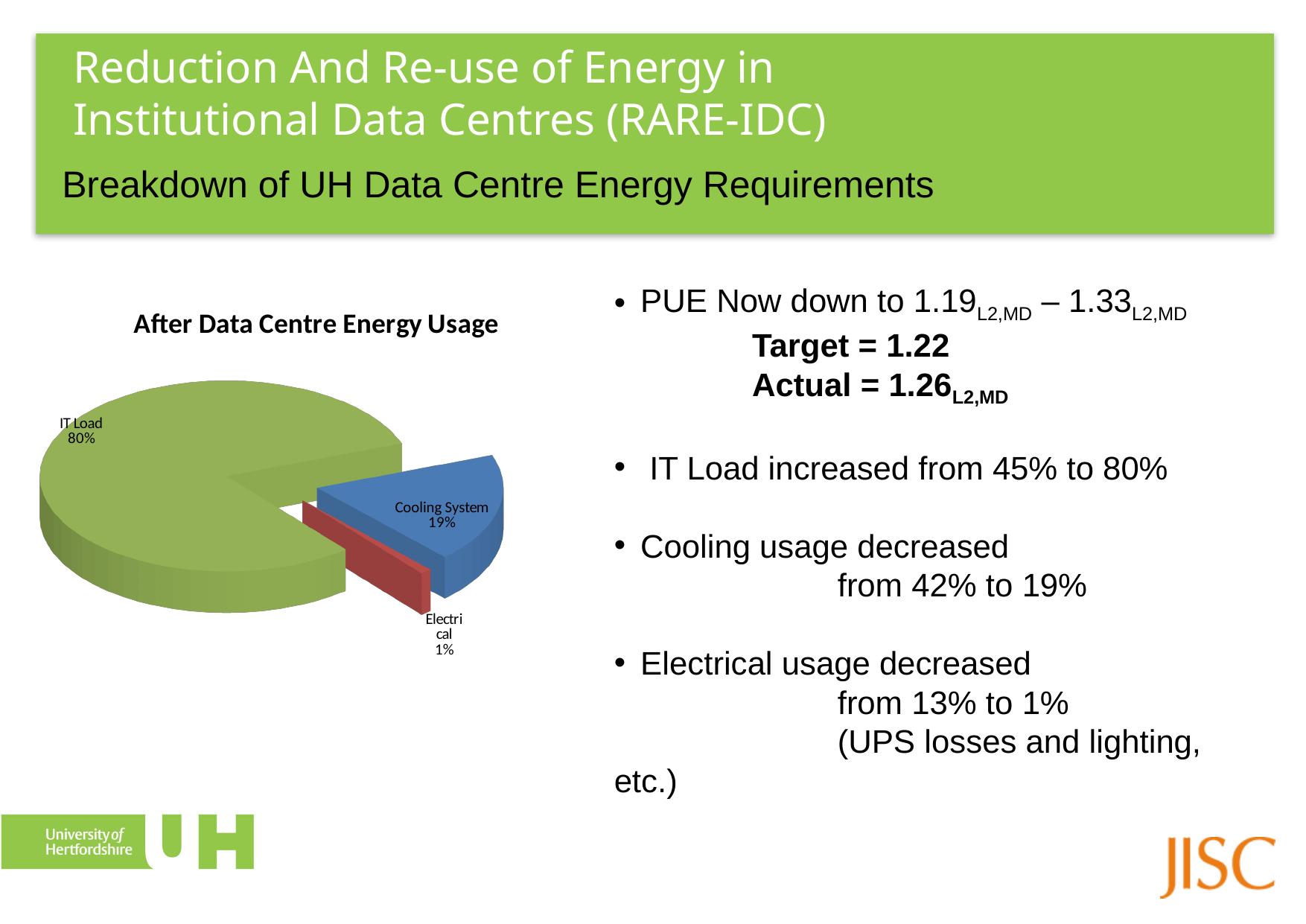
What share of the pie does IT Load represent? 80% What share of the pie does Cooling System represent? 19% Which slice of the pie chart is the smallest? Electrical What type of chart is shown on the slide? pie chart Which is larger, the Cooling System slice or the Electrical slice? Cooling System What is the difference in percentage points between the IT Load slice and the Cooling System slice? 61% How many slices does the pie chart have? 3 Which slice of the pie chart is the largest? IT Load What share of the pie does Electrical represent? 1% What is the combined share of the Cooling System and Electrical slices? 20% What is the title of the pie chart? After Data Centre Energy Usage What colour is the IT Load slice in the pie chart? green